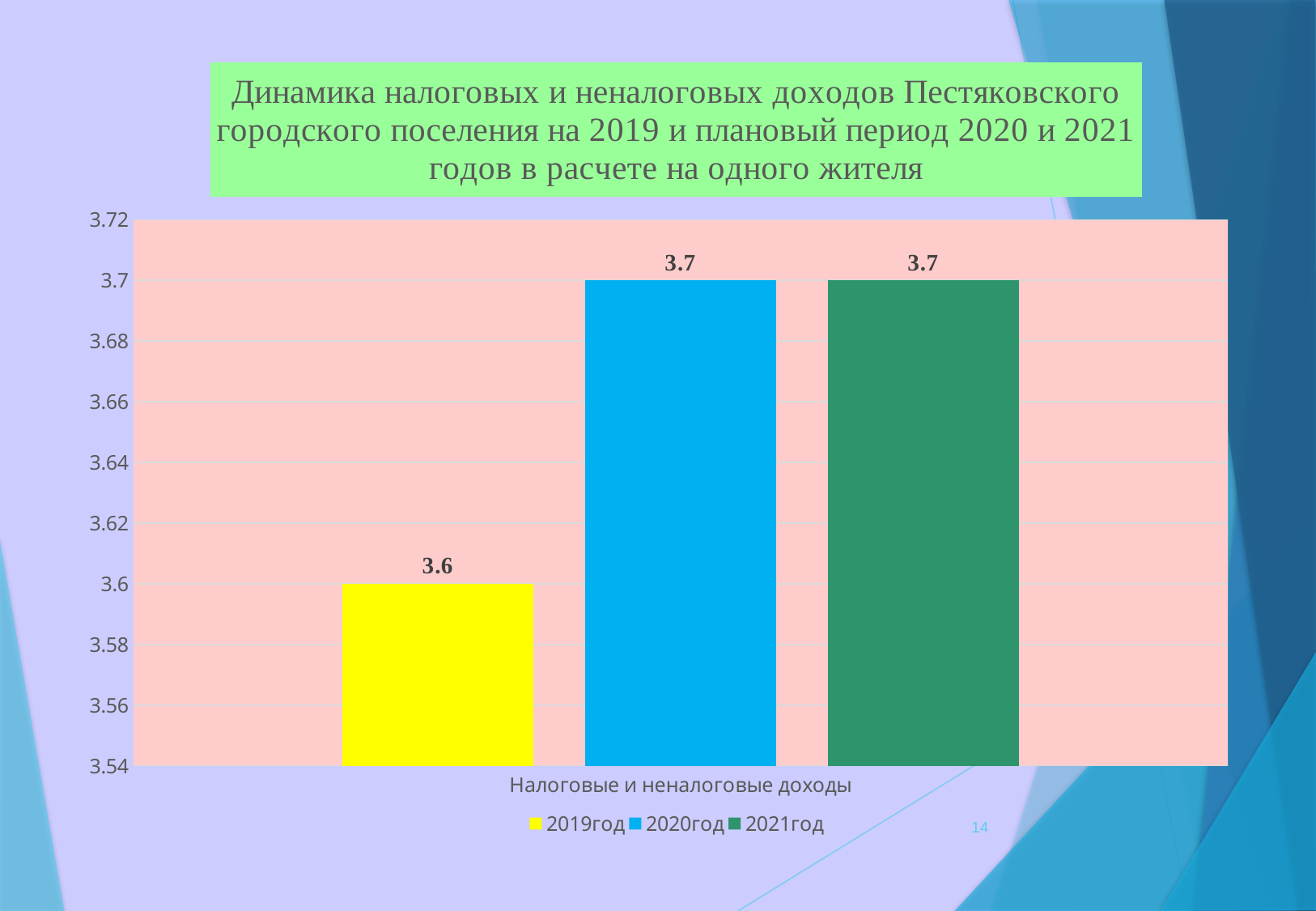
What kind of chart is shown on the slide? bar chart What is the value for 2021год? 3.7 Is the value for 2019год greater or less than 3.62? less Is the value for 2020год greater or less than 3.68? greater What is the value for 2019год? 3.6 Which is larger, the value for 2019год or the value for 2021год? 2021год What is the difference between the values for 2020год and 2019год? 0.1 What is the value for 2020год? 3.7 What is the category label shown on the x axis? Налоговые и неналоговые доходы How many series does the legend list? 3 Which year has the lowest value? 2019год What colour is the bar for 2021год? green